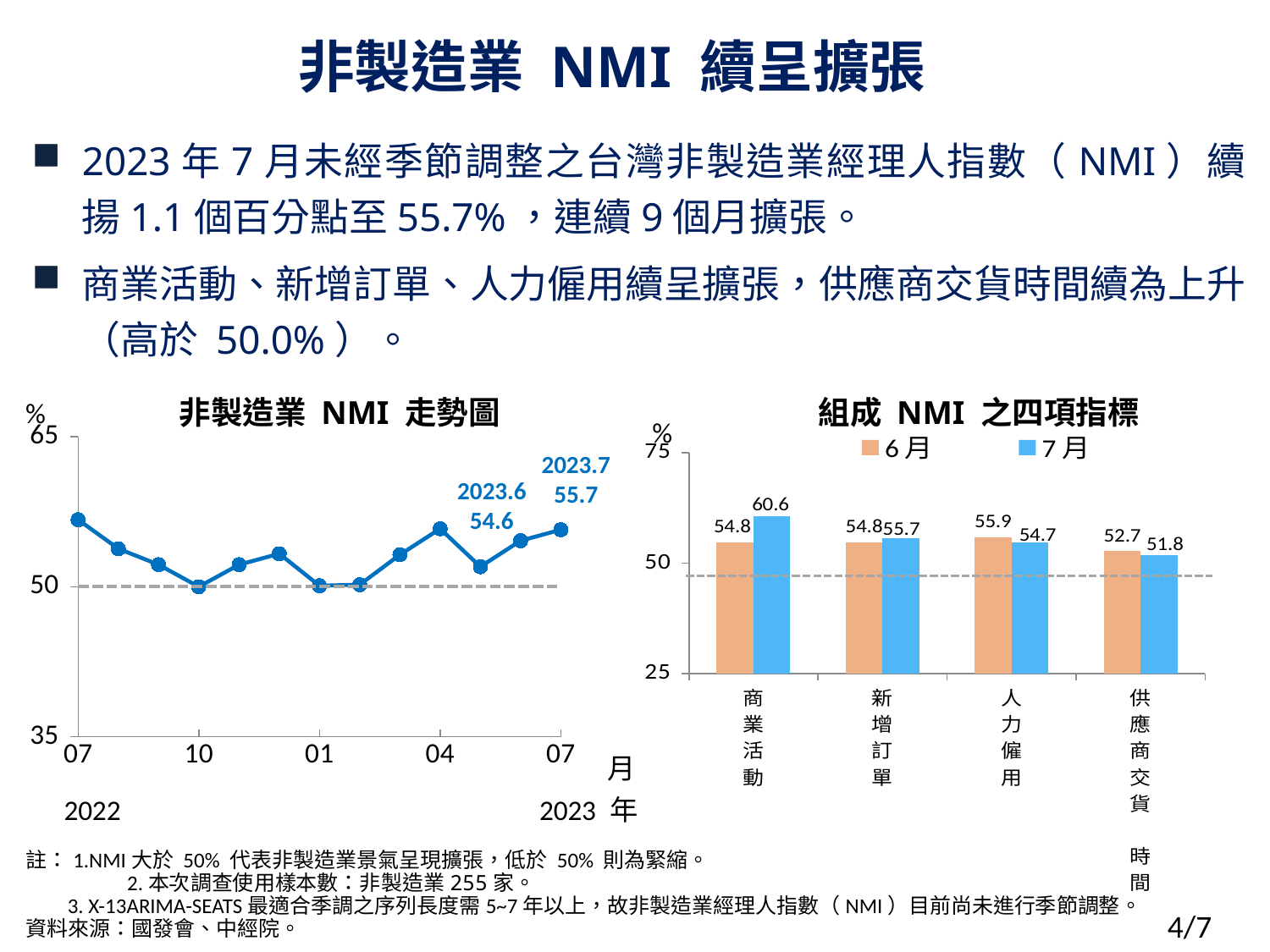
In the chart titled 組成 NMI 之四項指標, which category has the highest 7月 value? 商業活動 In the chart titled 非製造業 NMI 走勢圖, what is the difference between the 2023.7 and 2023.6 values? 1.1 In the chart titled 組成 NMI 之四項指標, how many categories are shown on the x axis? 4 In the chart titled 組成 NMI 之四項指標, is the 6月 or the 7月 value larger for 人力僱用? 6月 In the chart titled 組成 NMI 之四項指標, which category has the lowest 7月 value? 供應商交貨時間 In the chart titled 組成 NMI 之四項指標, what is the 7月 value for 商業活動? 60.6 What kind of chart is the chart titled 非製造業 NMI 走勢圖? line chart In the chart titled 組成 NMI 之四項指標, what is the 7月 value for 供應商交貨時間? 51.8 In the chart titled 非製造業 NMI 走勢圖, what is the value labeled for 2023.7? 55.7 In the chart titled 組成 NMI 之四項指標, what is the difference between the 7月 and 6月 values for 商業活動? 5.8 In the chart titled 組成 NMI 之四項指標, how many series does the legend list? 2 In the chart titled 組成 NMI 之四項指標, what is the 6月 value for 人力僱用? 55.9